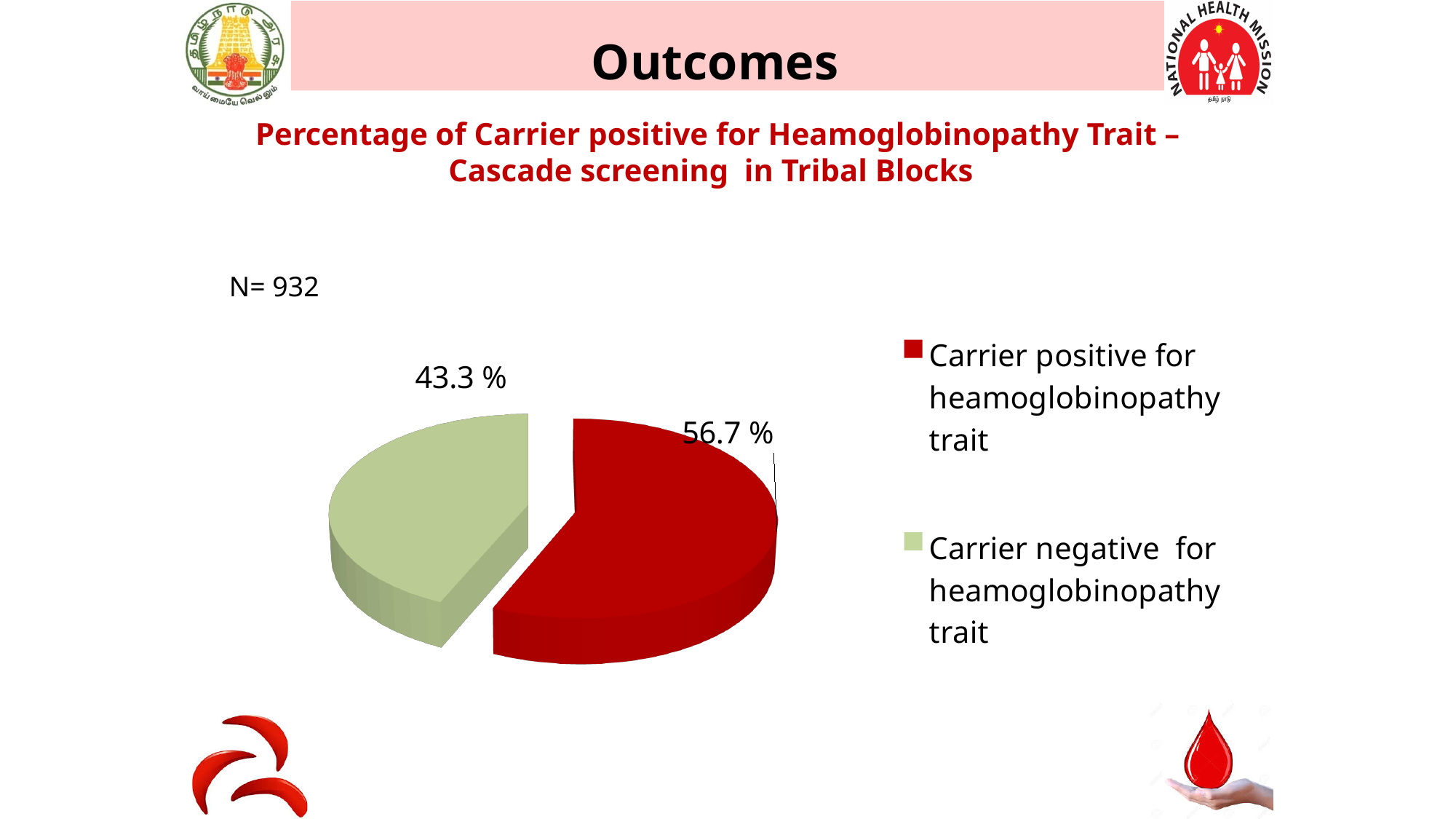
How many slices does the pie chart have? 2 How many entries does the legend list? 2 Is the share for Carrier negative for heamoglobinopathy trait greater or less than 50%? less What percentage of the pie is labelled for Carrier positive for heamoglobinopathy trait? 56.7 % Which is larger: the Carrier positive slice or the Carrier negative slice? Carrier positive for heamoglobinopathy trait What is the sample size (N) stated on the slide for the pie chart? 932 What kind of chart is shown on the slide? pie chart Which slice of the pie is the largest? Carrier positive for heamoglobinopathy trait Which slice of the pie is the smallest? Carrier negative for heamoglobinopathy trait What is the difference in percentage points between the Carrier positive and Carrier negative slices? 13.4 What percentage of the pie is labelled for Carrier negative for heamoglobinopathy trait? 43.3 % What colour is the Carrier positive for heamoglobinopathy trait slice? red